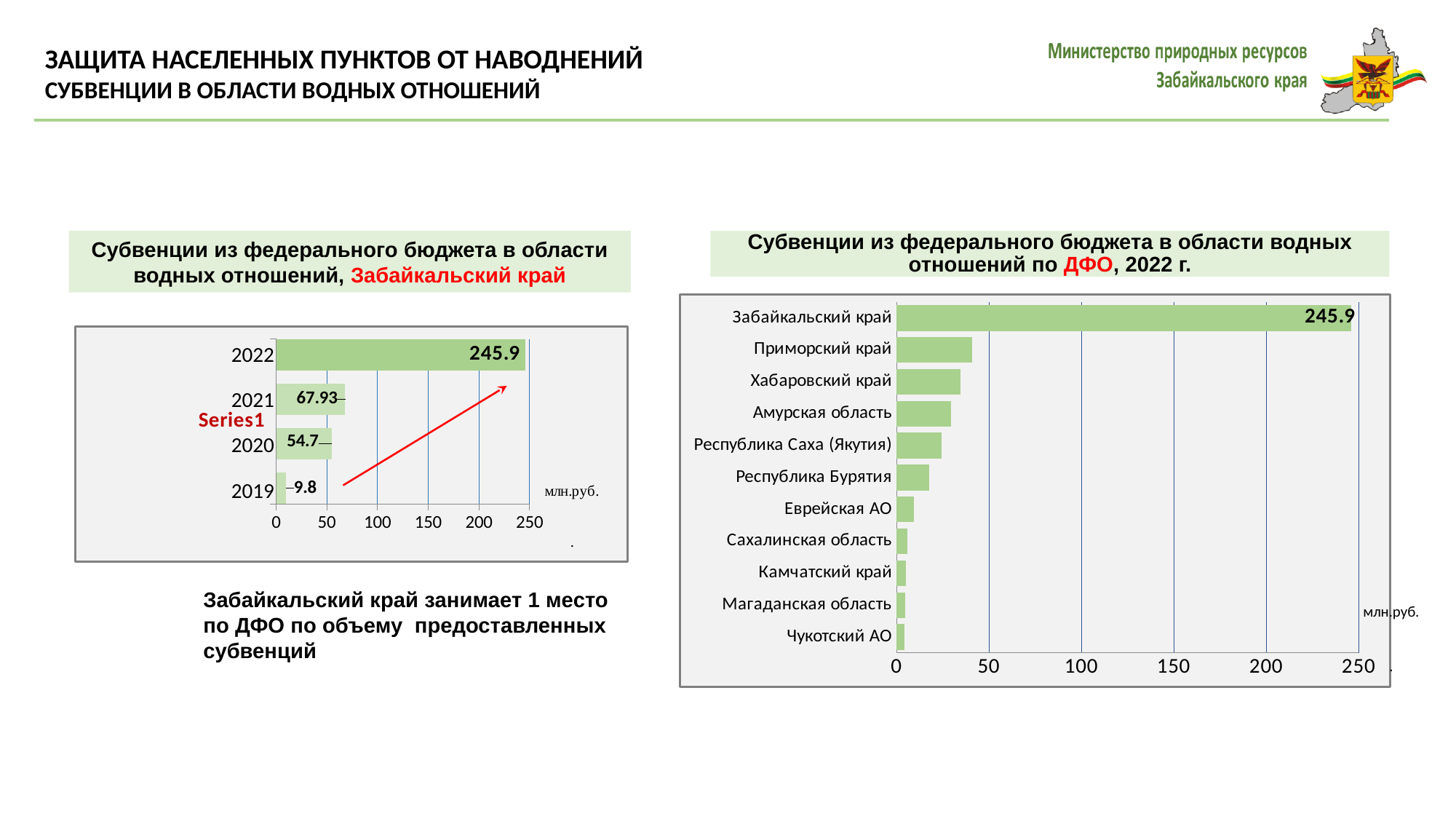
In the right chart (Субвенции по ДФО, 2022 г.), is the value for Приморский край greater or less than 50? less In the left chart (Забайкальский край), what is the value for 2019? 9.8 In the right chart (Субвенции по ДФО, 2022 г.), what is the value for Забайкальский край? 245.9 In the left chart (Субвенции из федерального бюджета в области водных отношений, Забайкальский край), what is the value for 2022? 245.9 In the left chart (Забайкальский край), what is the value for 2021? 67.93 In the right chart (Субвенции по ДФО, 2022 г.), which region has the highest value? Забайкальский край In the right chart (Субвенции по ДФО, 2022 г.), which is larger: the value for Хабаровский край or the value for Республика Бурятия? Хабаровский край In the left chart (Забайкальский край), what is the difference between the 2020 and 2019 values? 44.9 In the left chart (Забайкальский край), do the values rise or fall from 2019 to 2022? rise In the right chart (Субвенции по ДФО, 2022 г.), how many regions are plotted? 11 In the left chart (Забайкальский край), how many years are plotted? 4 In the left chart (Забайкальский край), which year has the lowest value? 2019